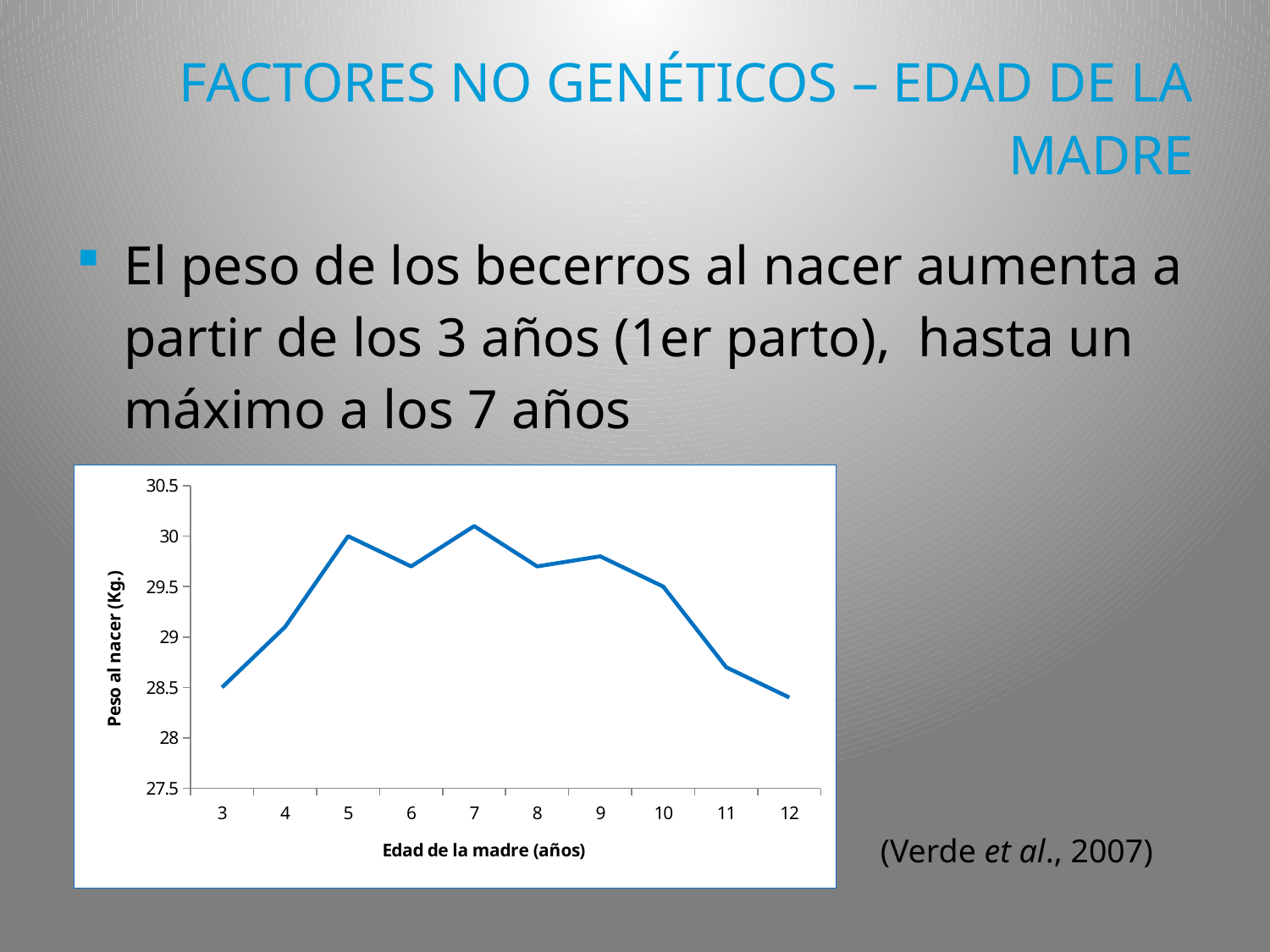
Is the birth weight at a mother's age of 4 years greater or less than 29.5? less What is the birth weight (Kg.) at a mother's age of 5 years? 30 Is the birth weight at a mother's age of 11 years greater or less than 29? less What kind of chart is shown on the slide? line chart Is the birth weight at a mother's age of 6 years greater or less than 29.5? greater Which has the higher birth weight: a mother's age of 5 years or 11 years? 5 years At which mother's age (años) does the birth weight reach its highest value? 7 How many data points are plotted on the line chart? 10 Does the birth weight rise or fall as the mother's age goes from 3 to 5 years? rise What is the title of the vertical axis of the chart? Peso al nacer (Kg.) Does the birth weight rise or fall as the mother's age goes from 10 to 12 years? fall